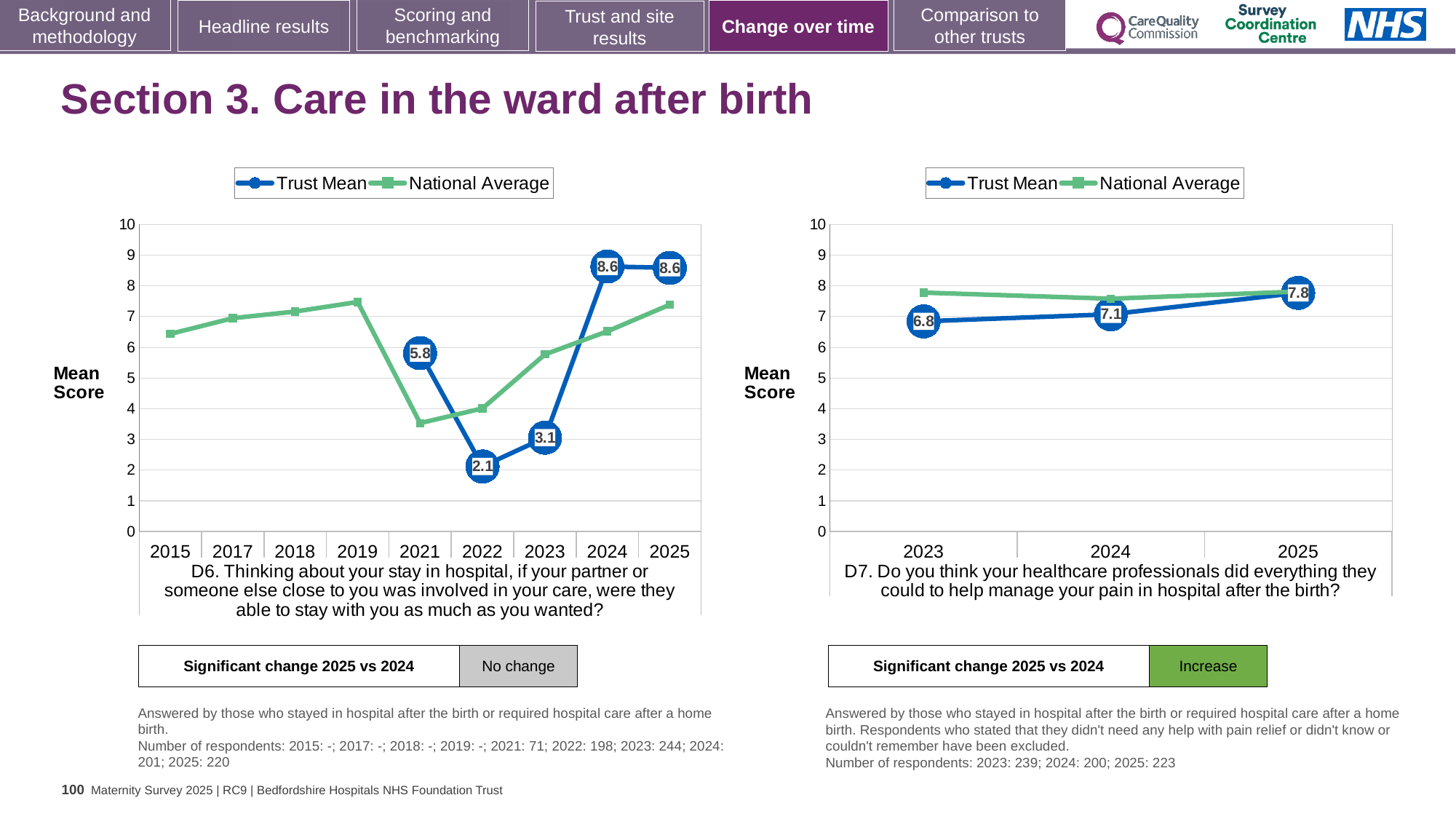
In the D7 chart (right), which year has the highest Trust Mean? 2025 In the D7 chart (right), how many series does the legend list? 2 In the D7 chart (right), what is the difference between the Trust Mean for 2025 and 2023? 1.0 In the D6 chart (left), what is the Trust Mean for 2022? 2.1 In the D6 chart (left), which year has the lowest Trust Mean? 2022 In the D7 chart (right), does the Trust Mean rise or fall from 2023 to 2025? rise In the D6 chart (left), how many years are shown on the x axis? 9 In the D7 chart (right), what is the Trust Mean for 2025? 7.8 What kind of chart is the D7 chart (right)? line chart In the D6 chart (left), is the National Average for 2019 greater or less than 7? greater In the D6 chart (left), what is the Trust Mean for 2021? 5.8 In the D6 chart (left), what is the difference between the Trust Mean for 2024 and 2023? 5.5